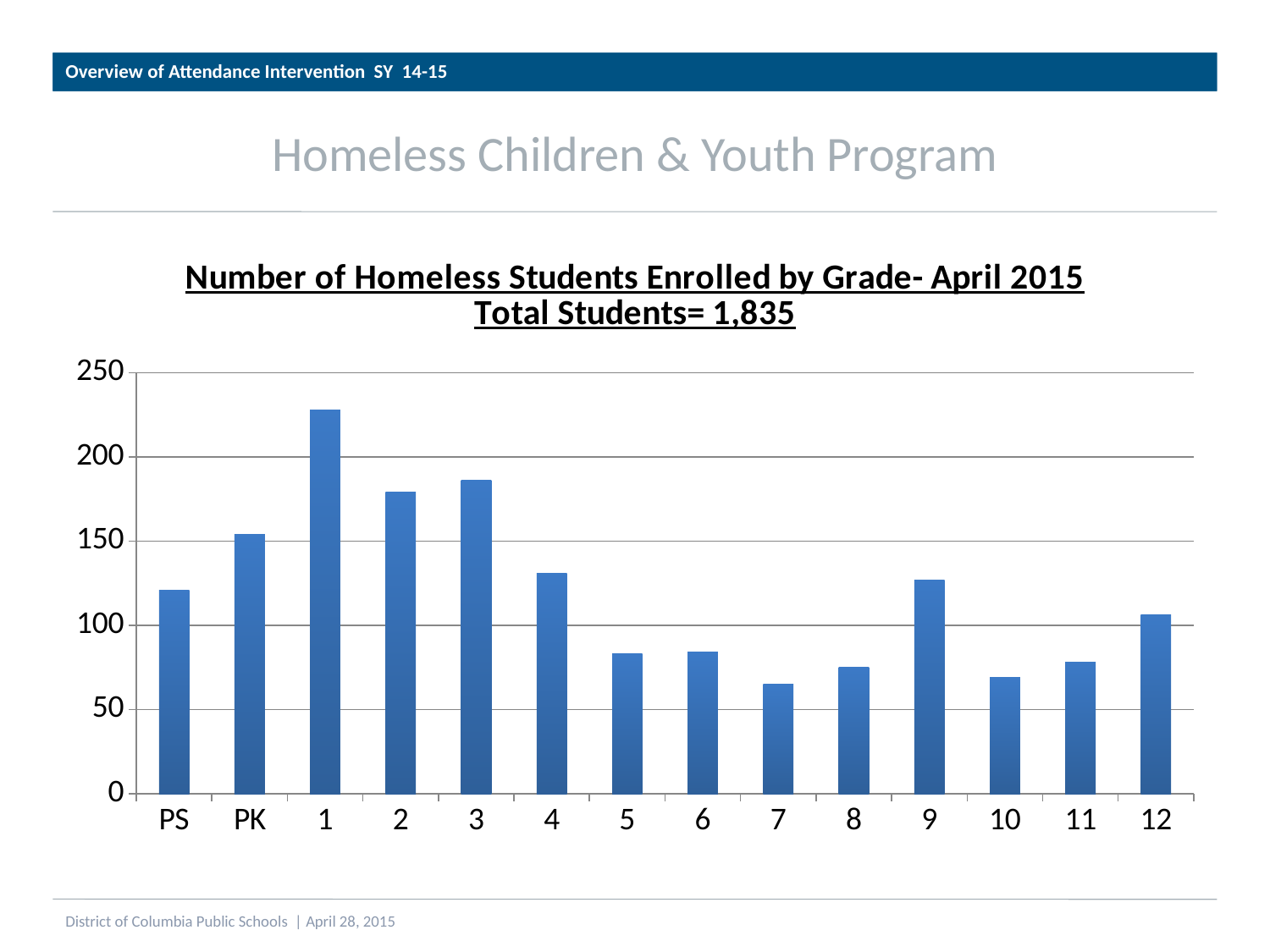
Which grade has the highest number of homeless students enrolled? 1 Is the value for PS greater or less than 100? greater According to the chart title, what is the total number of students? 1,835 Which has more homeless students enrolled, PK or PS? PK Is the value for grade 4 greater or less than 100? greater Is the value for grade 2 greater or less than 200? less How many grade categories are shown on the x axis? 14 Do the values rise or fall from grade 4 to grade 7? fall Which has more homeless students enrolled, grade 1 or grade 2? 1 What kind of chart is shown on the slide? bar chart